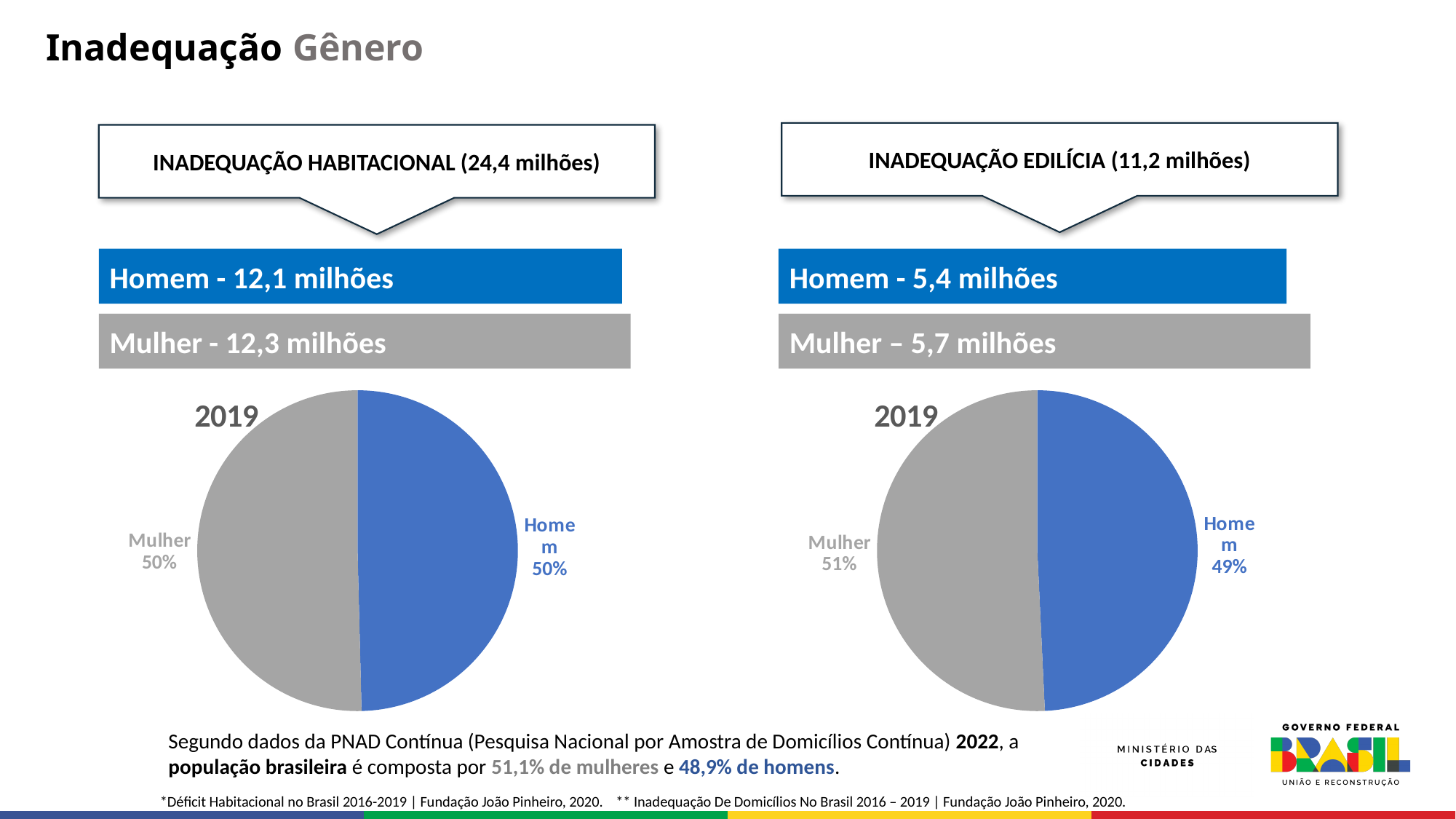
In the Inadequação Edilícia pie chart, what is the difference in percentage points between the Mulher and Homem shares? 2 percentage points In the Inadequação Edilícia pie chart, which slice is larger, Mulher or Homem? Mulher In the Inadequação Habitacional pie chart, what colour is the Homem slice? blue What kind of chart is shown under the Inadequação Edilícia heading? pie chart What year is shown next to the Inadequação Edilícia pie chart? 2019 What kind of chart is shown under the Inadequação Habitacional heading? pie chart In the Inadequação Habitacional pie chart, what share is labelled for Homem? 50% In the Inadequação Edilícia pie chart, which category has the smallest share? Homem How many slices does the Inadequação Habitacional pie chart have? 2 In the Inadequação Edilícia pie chart, what share is labelled for Mulher? 51% In the Inadequação Edilícia pie chart, what share is labelled for Homem? 49% In the Inadequação Habitacional pie chart, what share is labelled for Mulher? 50%